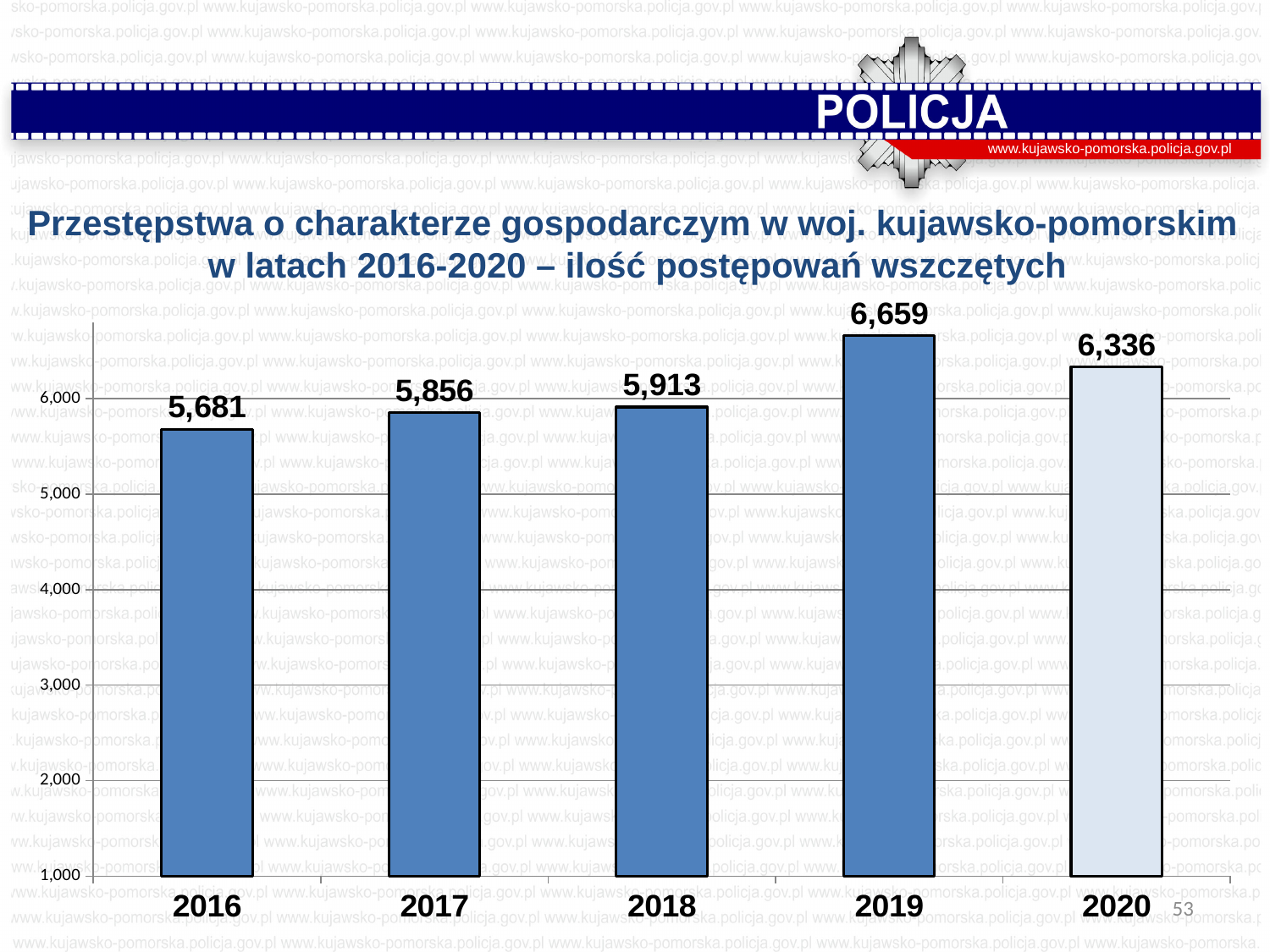
Is the value for 2017 greater or less than 6,000? less Which year has the highest value? 2019 What is the value for 2020? 6,336 What is the value for 2019? 6,659 Which is larger, the value for 2018 or the value for 2020? 2020 Which year has the lowest value? 2016 Do the values rise or fall from 2016 to 2019? rise What kind of chart is shown on the slide? bar chart How many years are shown on the chart? 5 What is the difference between the values for 2017 and 2016? 175 What is the value for 2016? 5,681 What is the difference between the values for 2019 and 2020? 323